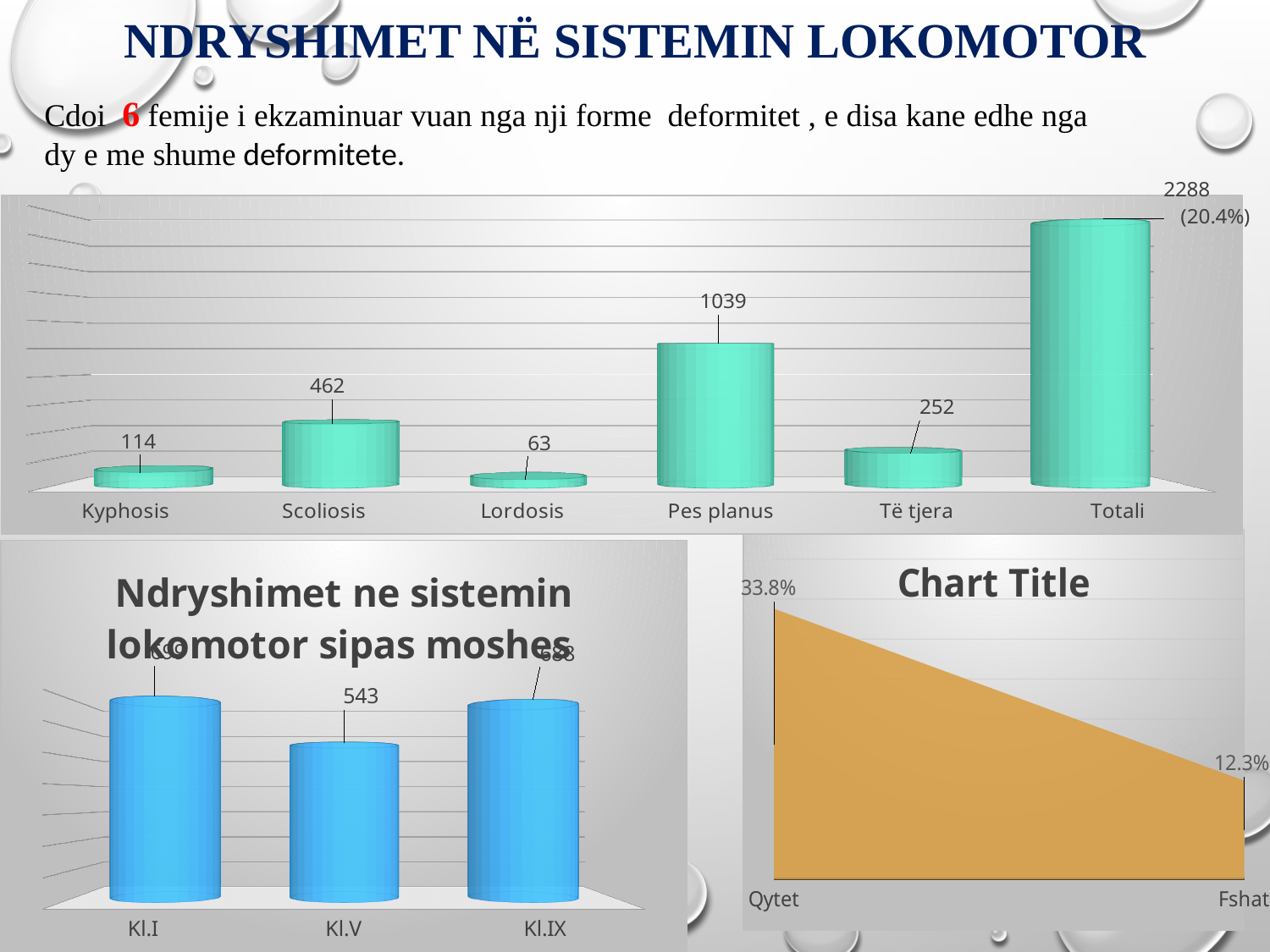
In the chart titled 'Ndryshimet ne sistemin lokomotor sipas moshes', which category has the lowest value? Kl.V In the top bar chart, which category has the highest value? Totali In the top bar chart, what is the value for Lordosis? 63 In the top bar chart, which is larger, the value for Kyphosis or the value for Të tjera? Të tjera In the chart titled 'Ndryshimet ne sistemin lokomotor sipas moshes', what is the value for Kl.V? 543 In the chart titled 'Chart Title', what is the value for Qytet? 33.8% What percentage is shown next to the Totali bar in the top chart? (20.4%) In the top bar chart, what is the value for Scoliosis? 462 In the top bar chart, which category has the lowest value? Lordosis In the top bar chart, what is the value for Pes planus? 1039 In the top bar chart, what is the difference between the values for Pes planus and Scoliosis? 577 How many categories are shown in the top bar chart? 6